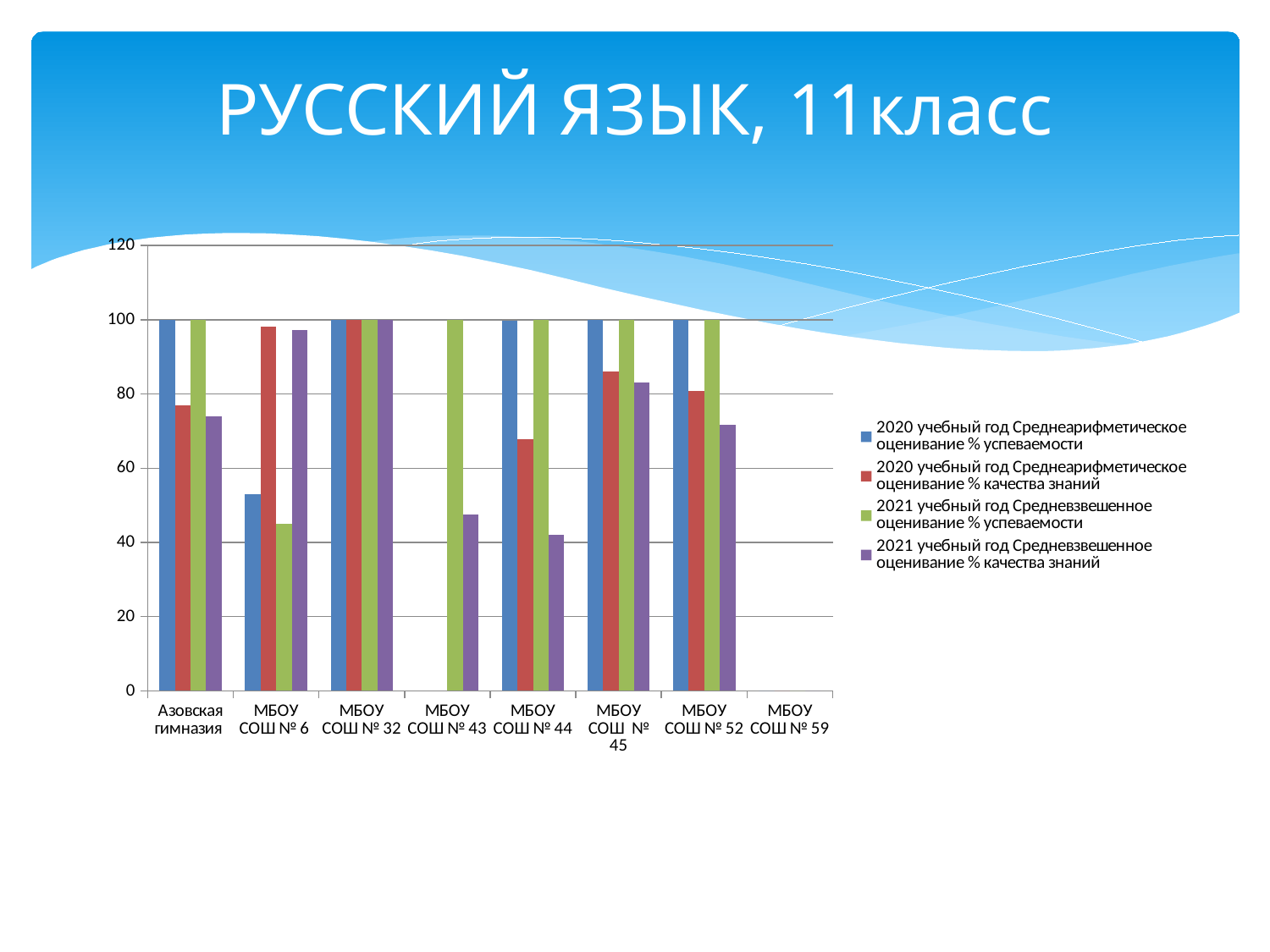
What kind of chart is shown on the slide? bar chart For МБОУ СОШ № 44, which is larger: '2020 учебный год Среднеарифметическое оценивание % качества знаний' or '2021 учебный год Средневзвешенное оценивание % качества знаний'? 2020 учебный год Среднеарифметическое оценивание % качества знаний For МБОУ СОШ № 6, which is larger: '2020 учебный год Среднеарифметическое оценивание % качества знаний' or '2021 учебный год Средневзвешенное оценивание % успеваемости'? 2020 учебный год Среднеарифметическое оценивание % качества знаний How many school categories are shown on the x axis? 8 What is the title of the slide containing the chart? РУССКИЙ ЯЗЫК, 11класс Is the value of '2021 учебный год Средневзвешенное оценивание % качества знаний' for МБОУ СОШ № 52 greater or less than 80? less Is the value of '2020 учебный год Среднеарифметическое оценивание % качества знаний' for МБОУ СОШ № 45 greater or less than 80? greater What is the value of '2020 учебный год Среднеарифметическое оценивание % успеваемости' for Азовская гимназия? 100 Is the value of '2020 учебный год Среднеарифметическое оценивание % успеваемости' for МБОУ СОШ № 6 greater or less than 60? less What is the value of '2021 учебный год Средневзвешенное оценивание % качества знаний' for МБОУ СОШ № 32? 100 What is the value of '2021 учебный год Средневзвешенное оценивание % успеваемости' for МБОУ СОШ № 43? 100 How many series does the legend list? 4